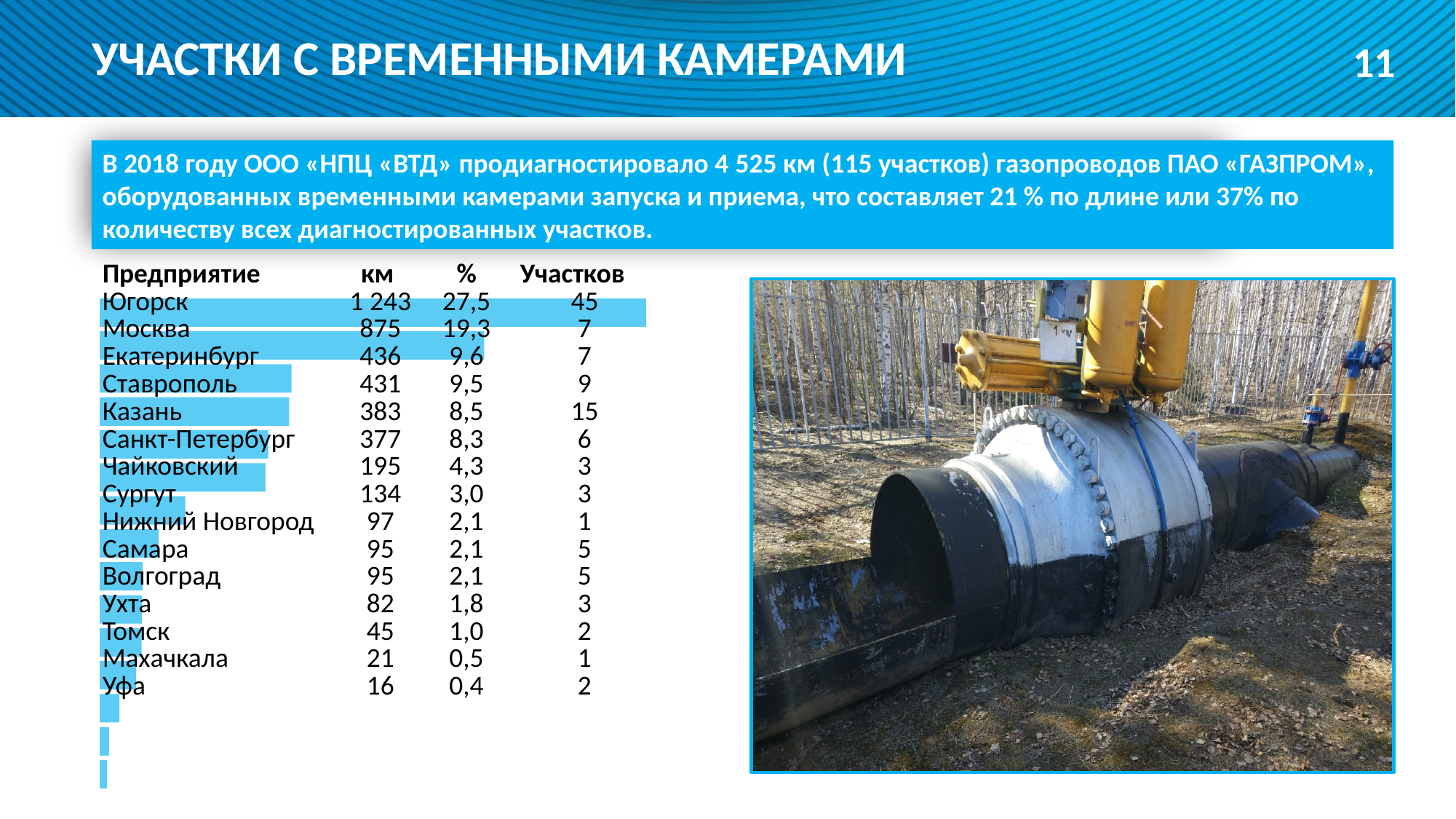
What is the difference in участков between Казань and Санкт-Петербург? 9 Which enterprise has the lowest km value? Уфа What is the difference in km between Югорск and Москва? 368 Which has more km, Ставрополь or Казань? Ставрополь What kind of chart is shown behind the table on the slide? bar chart Which enterprise has the most участков? Югорск Which enterprise has the highest km value? Югорск How many участков are listed for Казань? 15 Do the km values rise or fall going down the list from Югорск to Уфа? fall What percentage (%) is listed for Москва? 19,3 How many enterprises (Предприятие) are listed in the table? 15 How many km are listed for Югорск? 1 243